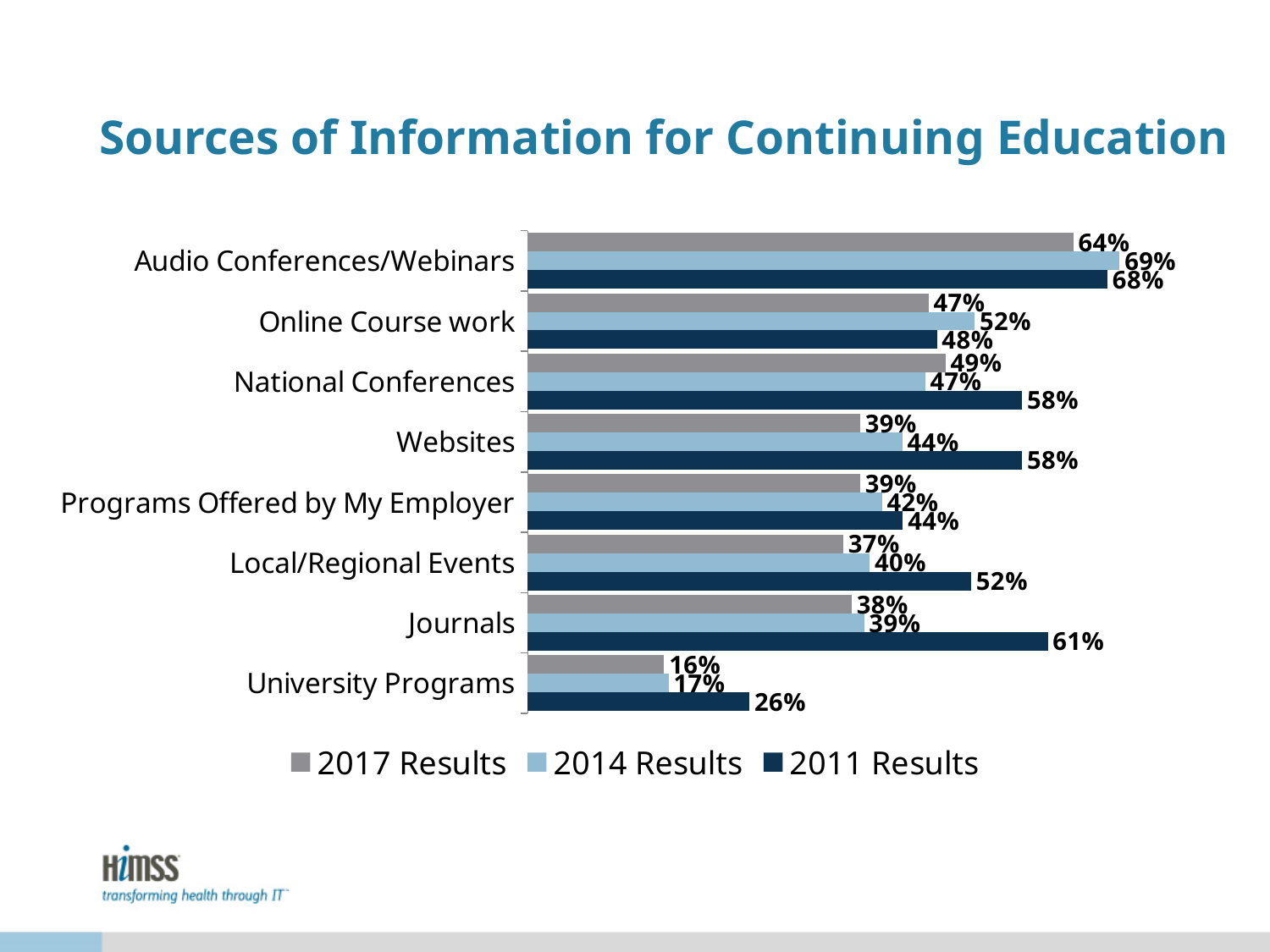
What is the difference between the 2011 Results and 2017 Results values for Journals? 23% Which category has the lowest 2011 Results value? University Programs How many series does the legend list? 3 What is the title of the chart? Sources of Information for Continuing Education How many categories are shown on the chart? 8 Which category has the highest 2017 Results value? Audio Conferences/Webinars What is the 2017 Results value for Audio Conferences/Webinars? 64% What kind of chart is shown on the slide? Bar chart What is the 2011 Results value for Journals? 61% What is the 2014 Results value for Online Course work? 52% Which is larger for Websites: the 2014 Results value or the 2011 Results value? 2011 Results Which series is shown in the darkest blue colour? 2011 Results